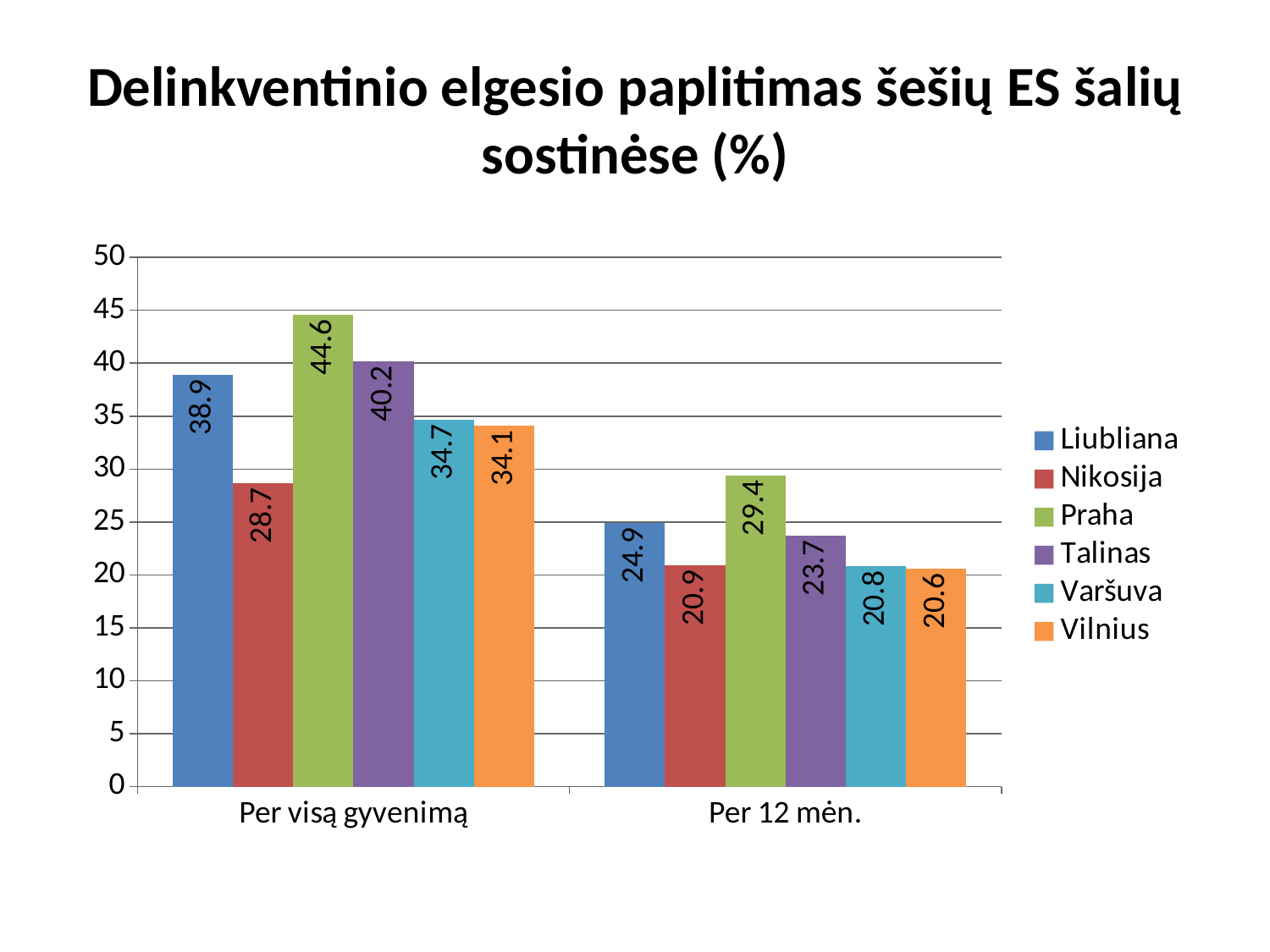
What is the title of the chart? Delinkventinio elgesio paplitimas šešių ES šalių sostinėse (%) What kind of chart is shown on the slide? Bar chart Which city has the highest value in the 'Per visą gyvenimą' category? Praha How many categories are shown on the x axis? 2 How many series does the legend list? 6 What is the value for Praha in the 'Per visą gyvenimą' category? 44.6 What is the difference between the Liubliana values for 'Per visą gyvenimą' and 'Per 12 mėn.'? 14 What is the value for Vilnius in the 'Per 12 mėn.' category? 20.6 Which city has the lowest value in the 'Per 12 mėn.' category? Vilnius Which is larger in the 'Per 12 mėn.' category: Talinas or Nikosija? Talinas What is the value for Nikosija in the 'Per visą gyvenimą' category? 28.7 Is the value for Talinas in the 'Per visą gyvenimą' category greater or less than 35? greater